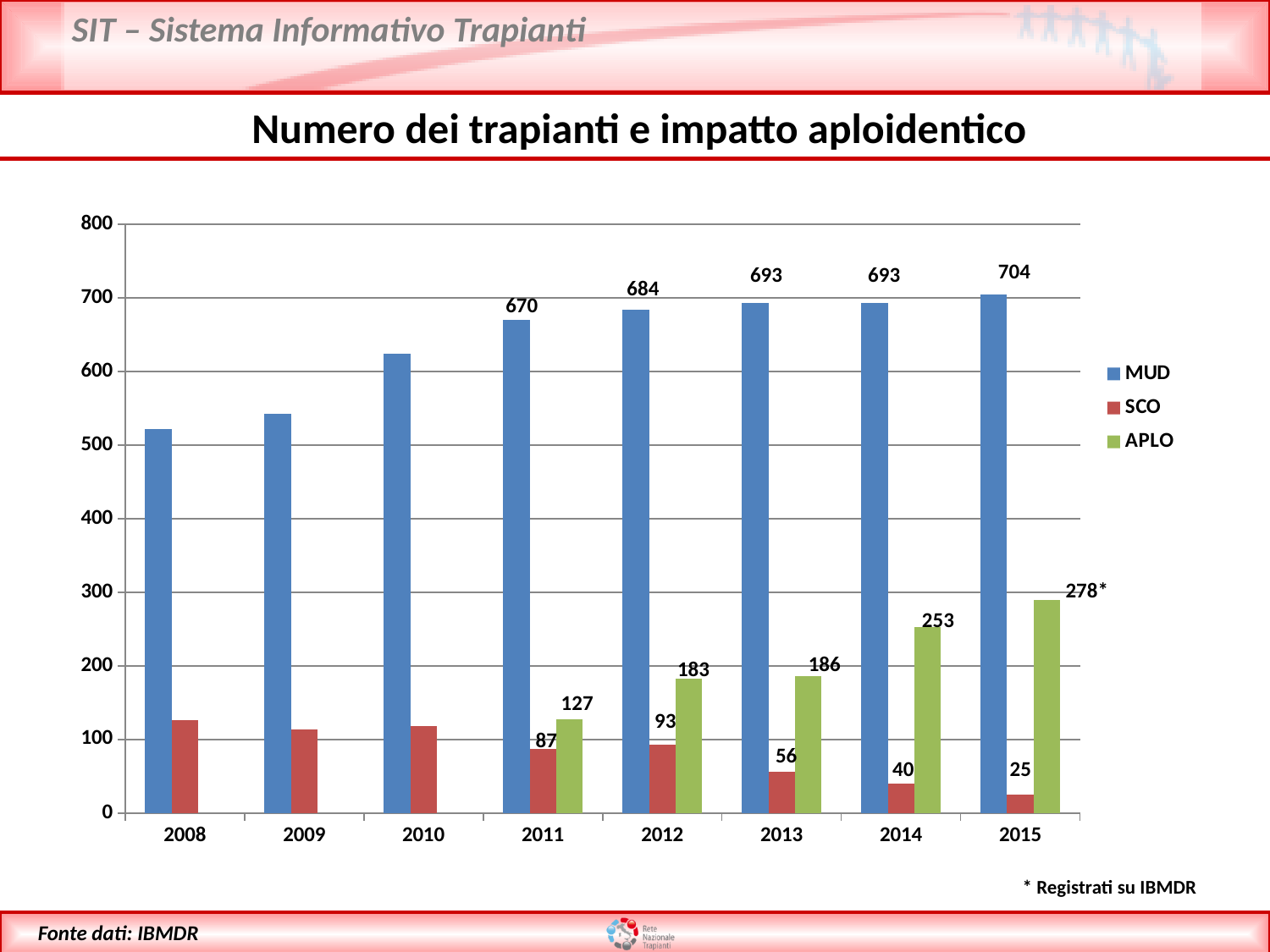
What kind of chart is shown on the slide? bar chart What is the difference between the MUD values for 2015 and 2011? 34 Does the MUD value rise or fall from 2008 to 2015? rise What is the MUD value for 2015? 704 Is the MUD value for 2008 greater or less than 600? less What is the SCO value for 2013? 56 How many years are shown on the x axis? 8 How many series does the legend list? 3 What is the APLO value for 2012? 183 In which year is the SCO value lowest? 2015 In which year is the MUD value highest? 2015 In 2014, which is larger, the APLO value or the SCO value? APLO